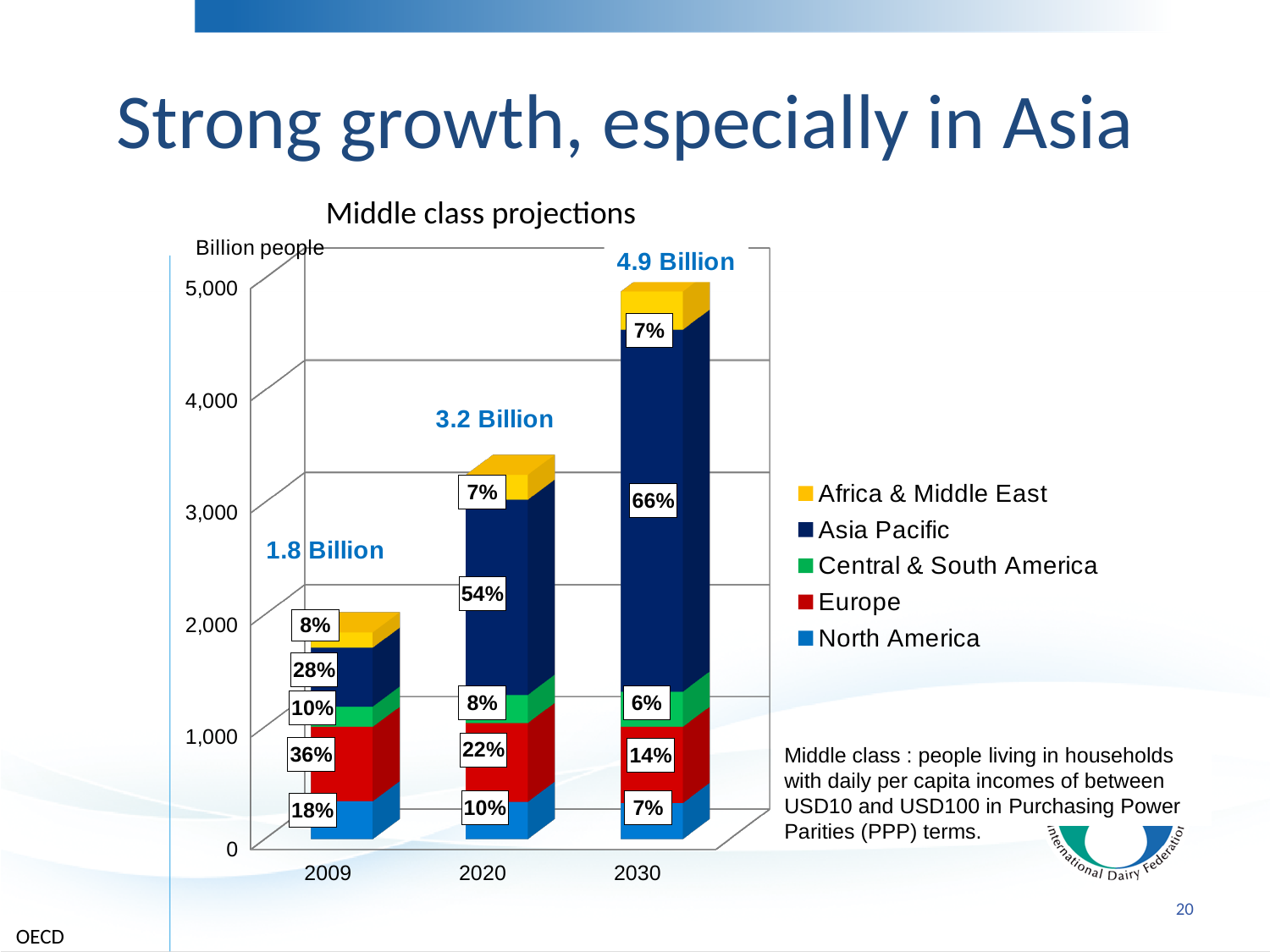
What percentage is shown for Europe in 2009? 36% Which is larger in 2020: the Europe share or the Central & South America share? Europe What kind of chart is shown on the slide? Stacked bar chart By how many percentage points does the Asia Pacific share in 2030 exceed its share in 2009? 38 percentage points Which region has the smallest share in 2030? Central & South America What total middle class population is labelled above the 2020 bar? 3.2 Billion How many series does the legend list? 5 Is the total height of the 2009 bar greater or less than 2,000? less What total is labelled above the 2030 bar? 4.9 Billion What share of the middle class does Asia Pacific account for in 2030? 66% Which region has the largest share of the middle class in 2009? Europe What is the North America share in 2020? 10%